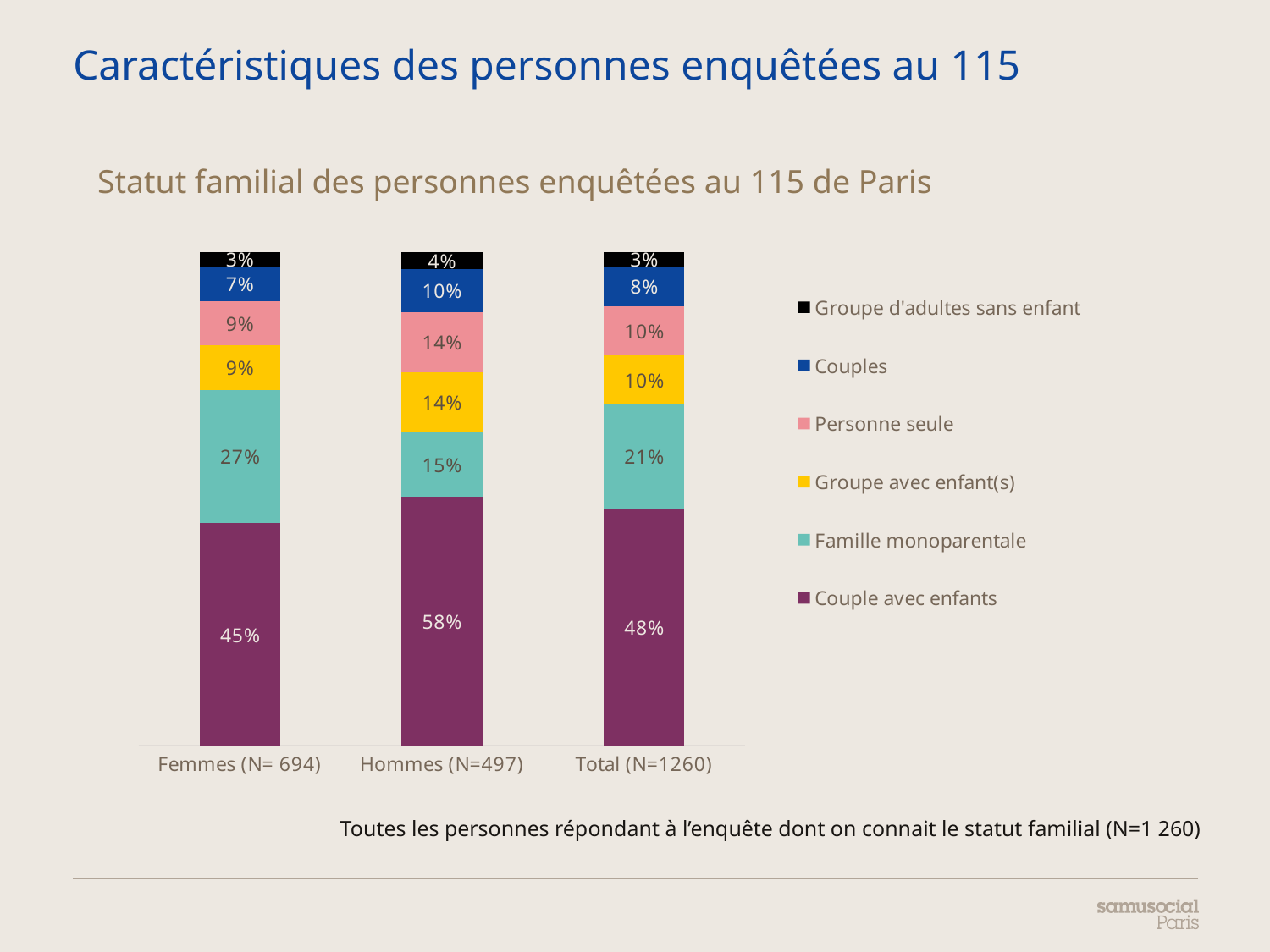
How many bars (categories) are shown on the x axis? 3 Which bar has the highest value for Couple avec enfants? Hommes (N=497) How many series does the legend list? 6 What is the value for Famille monoparentale in the Hommes (N=497) bar? 15% What kind of chart is shown on the slide? stacked bar chart What is the value for Couple avec enfants in the Femmes (N= 694) bar? 45% What is the difference between the Couple avec enfants values for Hommes (N=497) and Femmes (N= 694)? 13% Which bar has the lowest value for Famille monoparentale? Hommes (N=497) Which is larger: Personne seule for Femmes (N= 694) or Personne seule for Hommes (N=497)? Hommes (N=497) What is the value for Couples in the Total (N=1260) bar? 8% What is the value for Groupe d'adultes sans enfant in the Hommes (N=497) bar? 4% What is the title of the chart? Statut familial des personnes enquêtées au 115 de Paris